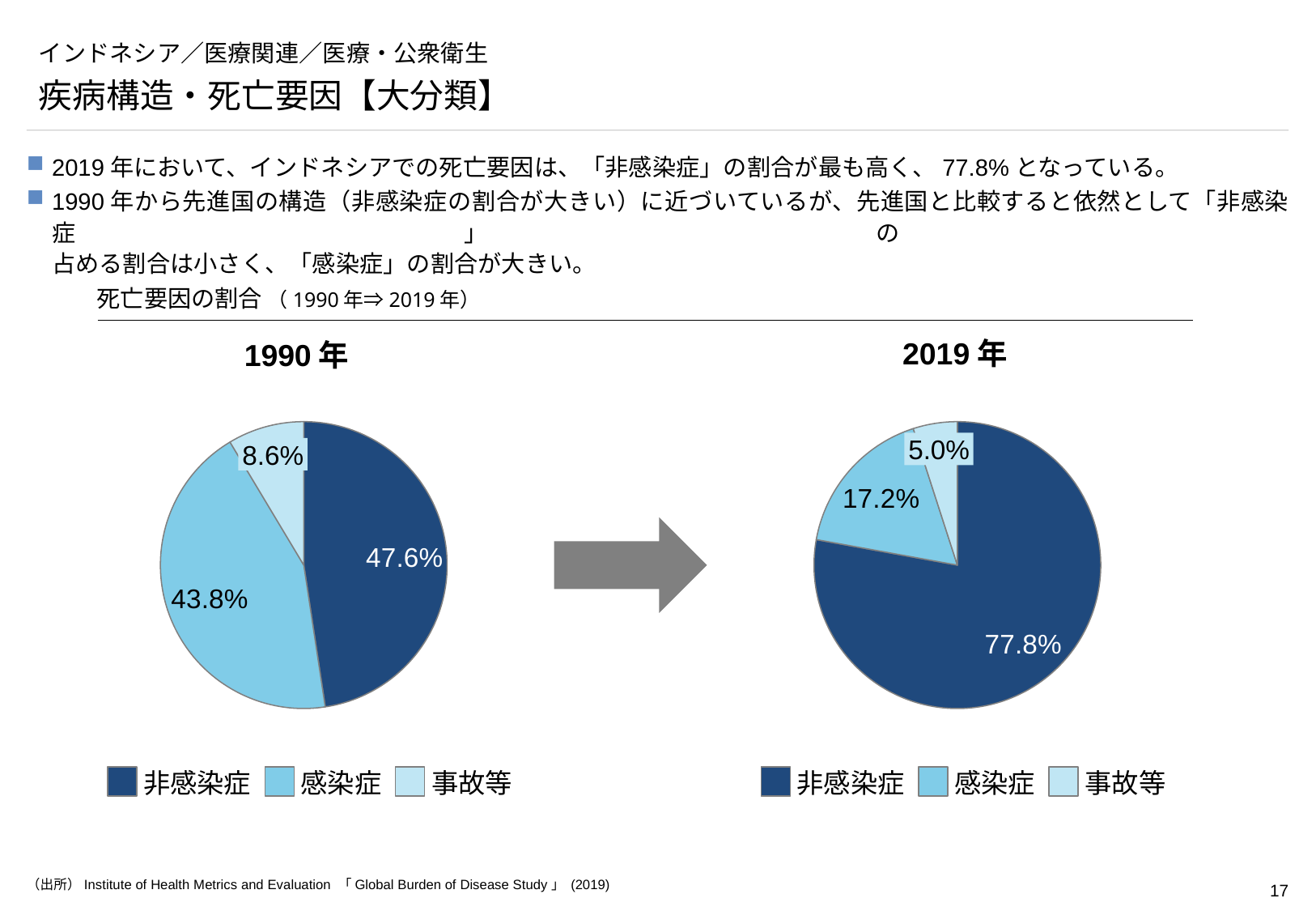
In the 2019年 pie chart, what is the share for 非感染症? 77.8% In the 2019年 pie chart, which category has the largest share? 非感染症 In the 1990年 pie chart, what is the share for 感染症? 43.8% In the 1990年 pie chart, what is the share for 非感染症? 47.6% In the 2019年 pie chart, what is the difference between the shares of 非感染症 and 感染症? 60.6% In the 1990年 pie chart, which category has the smallest share? 事故等 In the 2019年 pie chart, what is the share for 感染症? 17.2% How many categories does the legend of the 2019年 pie chart list? 3 In the 2019年 pie chart, what is the share for 事故等? 5.0% In the 1990年 pie chart, which is larger, the share of 非感染症 or 感染症? 非感染症 What kind of chart is the 1990年 chart? Pie chart In the 1990年 pie chart, what is the share for 事故等? 8.6%